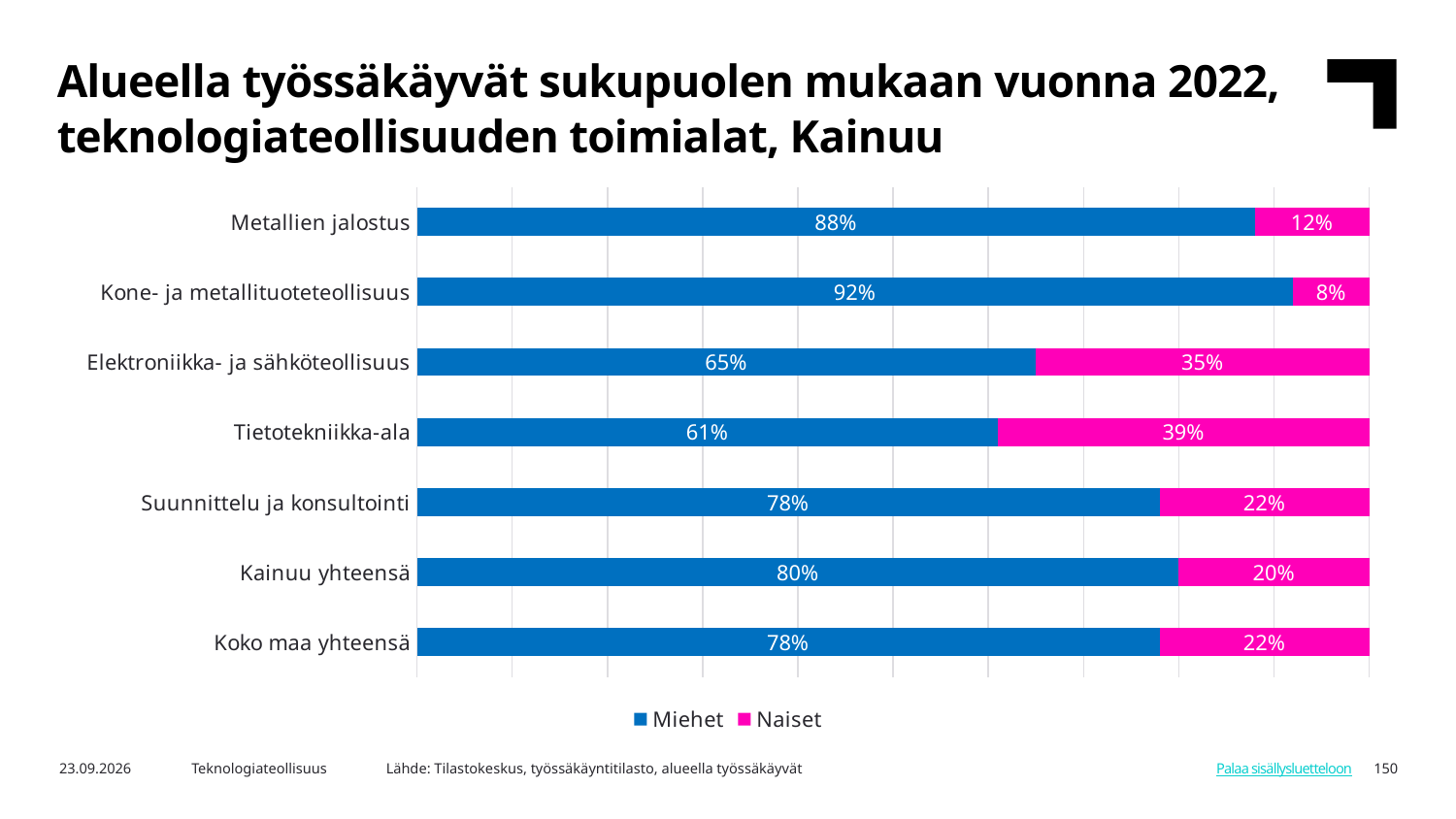
Which category has the highest Miehet share? Kone- ja metallituoteteollisuus What kind of chart is shown on the slide? Stacked bar chart How many series does the legend list? 2 How many categories are shown on the chart? 7 Which category has the lowest Miehet share? Tietotekniikka-ala What is the Miehet share for Metallien jalostus? 88% Which is larger: the Naiset share for Suunnittelu ja konsultointi or the Naiset share for Kainuu yhteensä? Suunnittelu ja konsultointi What is the total of the stacked bar for Koko maa yhteensä? 100% What is the Naiset share for Kainuu yhteensä? 20% Which category has the highest Naiset share? Tietotekniikka-ala What is the difference between the Miehet share for Kone- ja metallituoteteollisuus and the Miehet share for Elektroniikka- ja sähköteollisuus? 27 percentage points What is the Naiset share for Tietotekniikka-ala? 39%